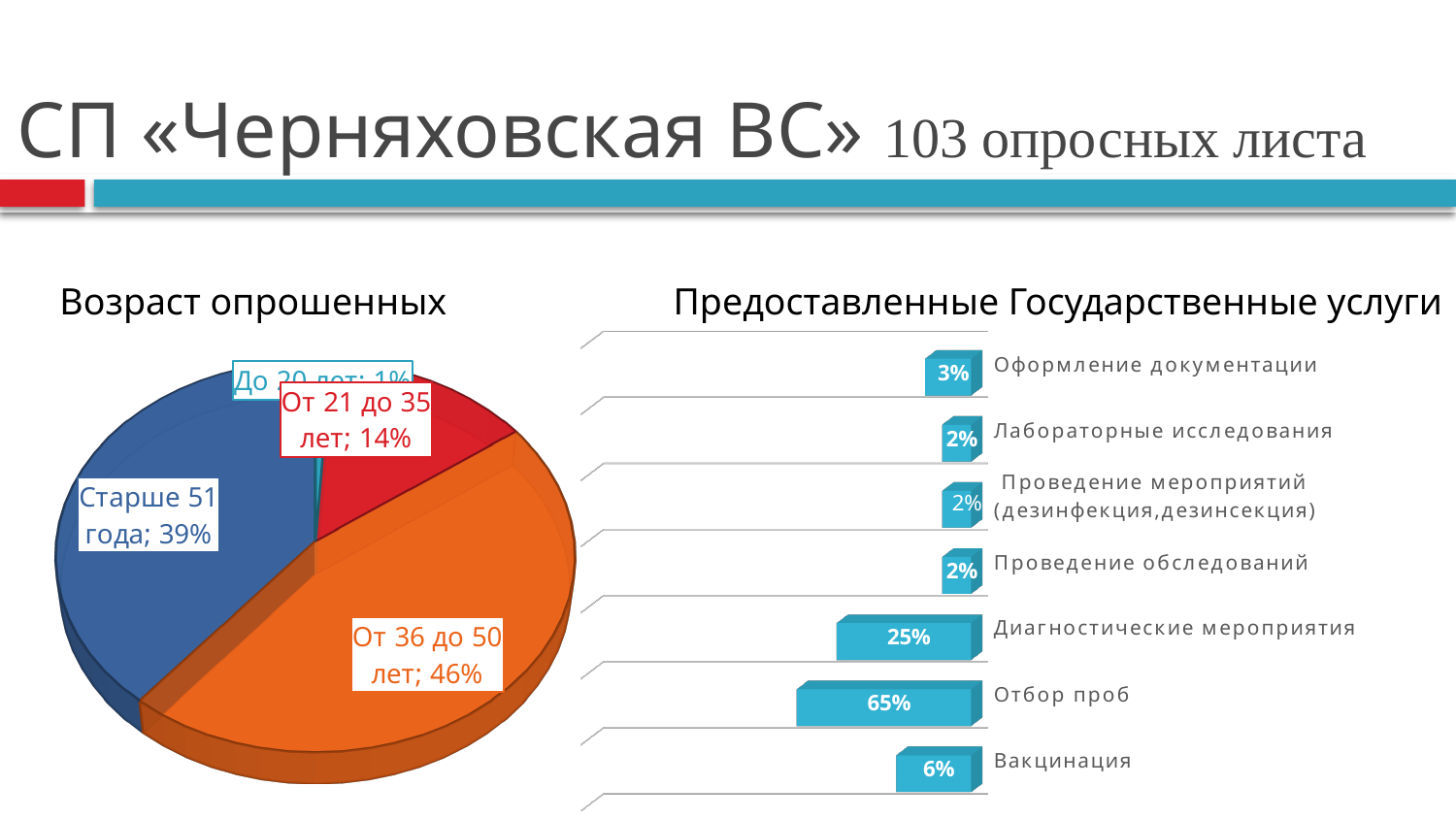
In the pie chart 'Возраст опрошенных', which age group has the smallest share? До 20 лет In the chart 'Предоставленные Государственные услуги', which service has the highest value? Отбор проб In the pie chart 'Возраст опрошенных', how many age groups are shown? 4 In the chart 'Предоставленные Государственные услуги', how many services are listed? 7 In the pie chart 'Возраст опрошенных', what share of respondents are 'Старше 51 года'? 39% In the pie chart 'Возраст опрошенных', which age group has the largest share? От 36 до 50 лет In the chart 'Предоставленные Государственные услуги', which is larger: 'Вакцинация' or 'Оформление документации'? Вакцинация In the chart 'Предоставленные Государственные услуги', what is the value for 'Отбор проб'? 65% In the chart 'Предоставленные Государственные услуги', what is the value for 'Диагностические мероприятия'? 25% In the pie chart 'Возраст опрошенных', what share of respondents are 'От 36 до 50 лет'? 46% In the pie chart 'Возраст опрошенных', what is the difference between the shares of 'От 36 до 50 лет' and 'От 21 до 35 лет'? 32% What type of chart is 'Предоставленные Государственные услуги'? Bar chart